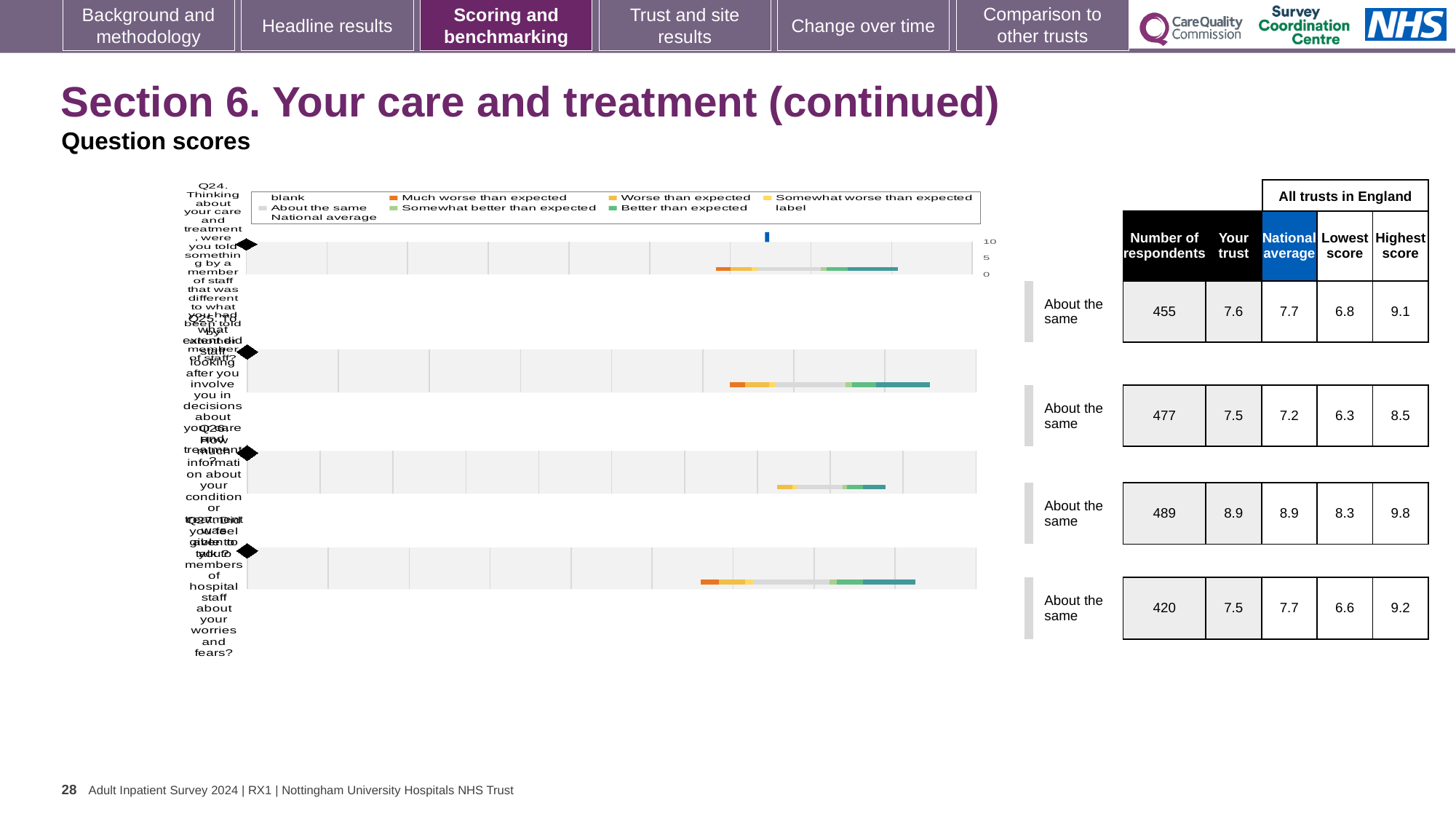
For the Q24 row, which is higher: the 'Your trust' score or the national average? National average What is the highest score across all trusts in England for the Q26 row? 9.8 Which question row has the highest 'Your trust' score? Q26 What is the number of respondents for the Q24 row? 455 What is the lowest score across all trusts in England for the Q25 row? 6.3 How many question rows (Q24 to Q27) are plotted on the slide? 4 In the chart legend, what colour represents 'Much worse than expected'? orange What kind of chart is used to show the benchmarking results for each question on this slide? bar chart Which question row has the lowest number of respondents? Q27 What benchmark category is shown next to the Q24 chart row? About the same For the Q25 row, what is the difference between the 'Your trust' score and the national average? 0.3 What is the 'Your trust' score for the Q26 row? 8.9